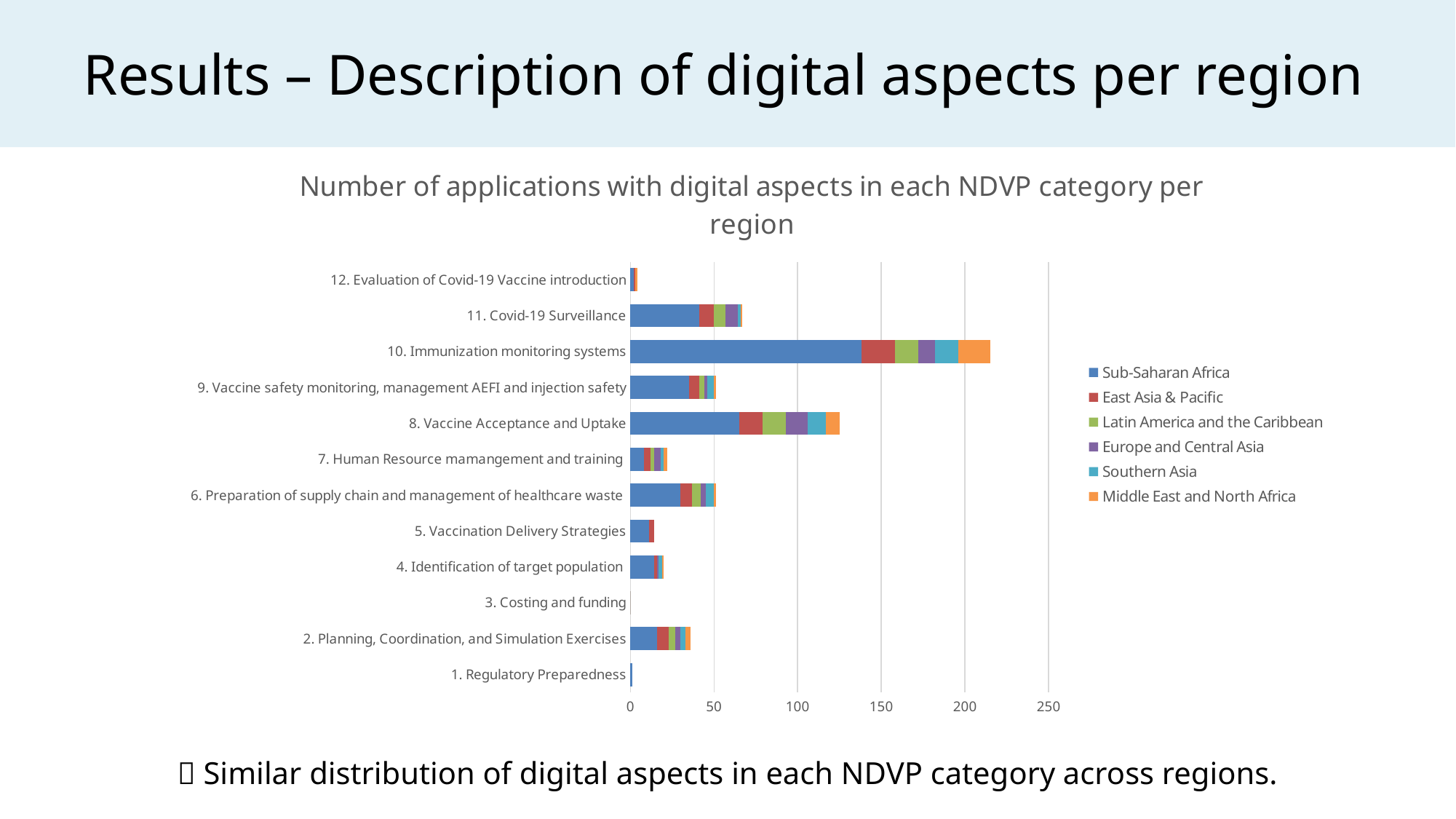
Which NDVP category has the smallest total bar? 3. Costing and funding Which NDVP category has the longest total bar? 10. Immunization monitoring systems Which region is listed first in the legend? Sub-Saharan Africa What is the title of the chart? Number of applications with digital aspects in each NDVP category per region Is the total value for 10. Immunization monitoring systems greater or less than 200? greater Is the total value for 5. Vaccination Delivery Strategies greater or less than 50? less How many series does the legend list? 6 Which has the larger total bar: 8. Vaccine Acceptance and Uptake or 11. Covid-19 Surveillance? 8. Vaccine Acceptance and Uptake How many NDVP categories are plotted on the chart? 12 What kind of chart is shown on the slide? Stacked bar chart Is the total value for 11. Covid-19 Surveillance greater or less than 50? greater